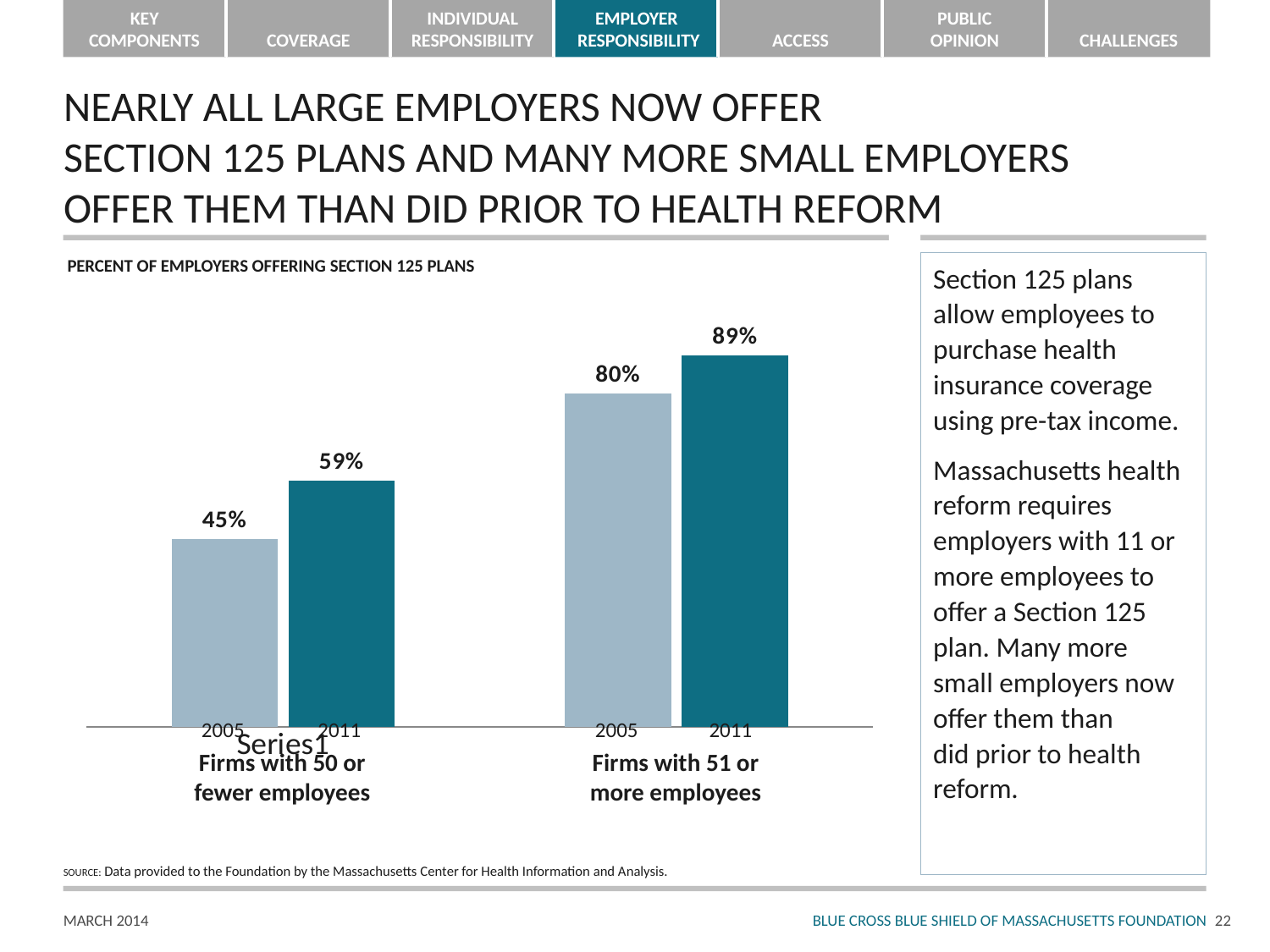
By how many percentage points did the share of firms with 50 or fewer employees offering Section 125 plans increase from 2005 to 2011? 14 percentage points In 2011, which group had a higher percent of employers offering Section 125 plans: firms with 50 or fewer employees or firms with 51 or more employees? Firms with 51 or more employees What is the title of the chart? PERCENT OF EMPLOYERS OFFERING SECTION 125 PLANS What percent of firms with 51 or more employees offered Section 125 plans in 2011? 89% How many bars are plotted in the chart? 4 What type of chart is shown on the slide? Bar chart Which bar shows the highest percent of employers offering Section 125 plans? Firms with 51 or more employees, 2011 What percent of firms with 50 or fewer employees offered Section 125 plans in 2005? 45% Which bar shows the lowest percent of employers offering Section 125 plans? Firms with 50 or fewer employees, 2005 What percent of firms with 50 or fewer employees offered Section 125 plans in 2011? 59% By how many percentage points did the share of firms with 51 or more employees offering Section 125 plans increase from 2005 to 2011? 9 percentage points What percent of firms with 51 or more employees offered Section 125 plans in 2005? 80%